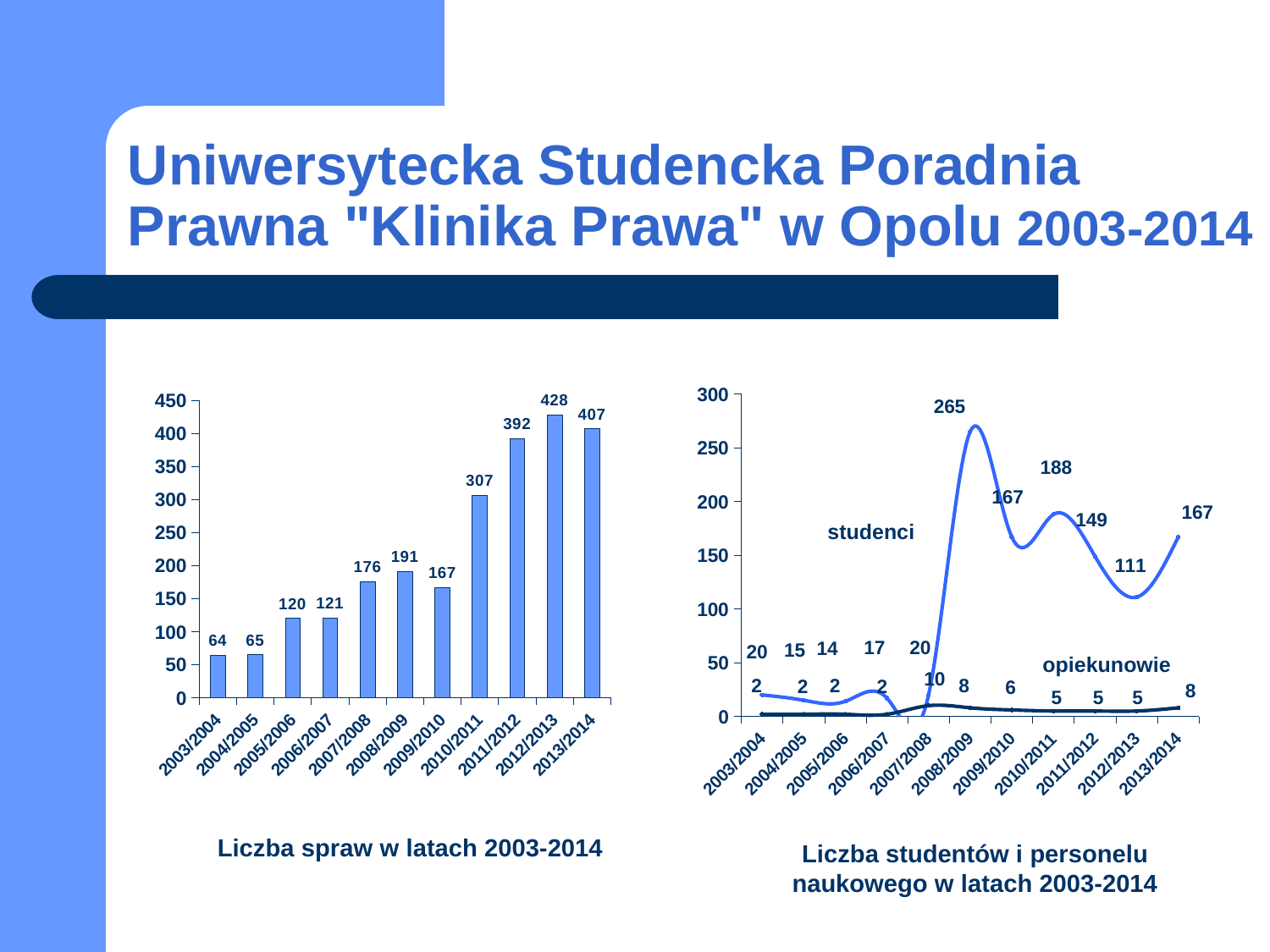
In the chart 'Liczba studentów i personelu naukowego w latach 2003-2014', what is the value for opiekunowie in 2013/2014? 8 In the chart 'Liczba spraw w latach 2003-2014', which year has the lowest value? 2003/2004 What kind of chart is 'Liczba spraw w latach 2003-2014'? bar chart How many years are shown in the chart 'Liczba spraw w latach 2003-2014'? 11 In the chart 'Liczba spraw w latach 2003-2014', which is larger: the value for 2008/2009 or 2009/2010? 2008/2009 How many series are shown in the chart 'Liczba studentów i personelu naukowego w latach 2003-2014'? 2 In the chart 'Liczba spraw w latach 2003-2014', which year has the highest value? 2012/2013 In the chart 'Liczba studentów i personelu naukowego w latach 2003-2014', what is the difference between the studenci values for 2008/2009 and 2009/2010? 98 In the chart 'Liczba spraw w latach 2003-2014', what is the difference between the values for 2012/2013 and 2013/2014? 21 In the chart 'Liczba studentów i personelu naukowego w latach 2003-2014', what is the value for studenci in 2008/2009? 265 In the chart 'Liczba spraw w latach 2003-2014', what is the value for 2010/2011? 307 What kind of chart is 'Liczba studentów i personelu naukowego w latach 2003-2014'? line chart